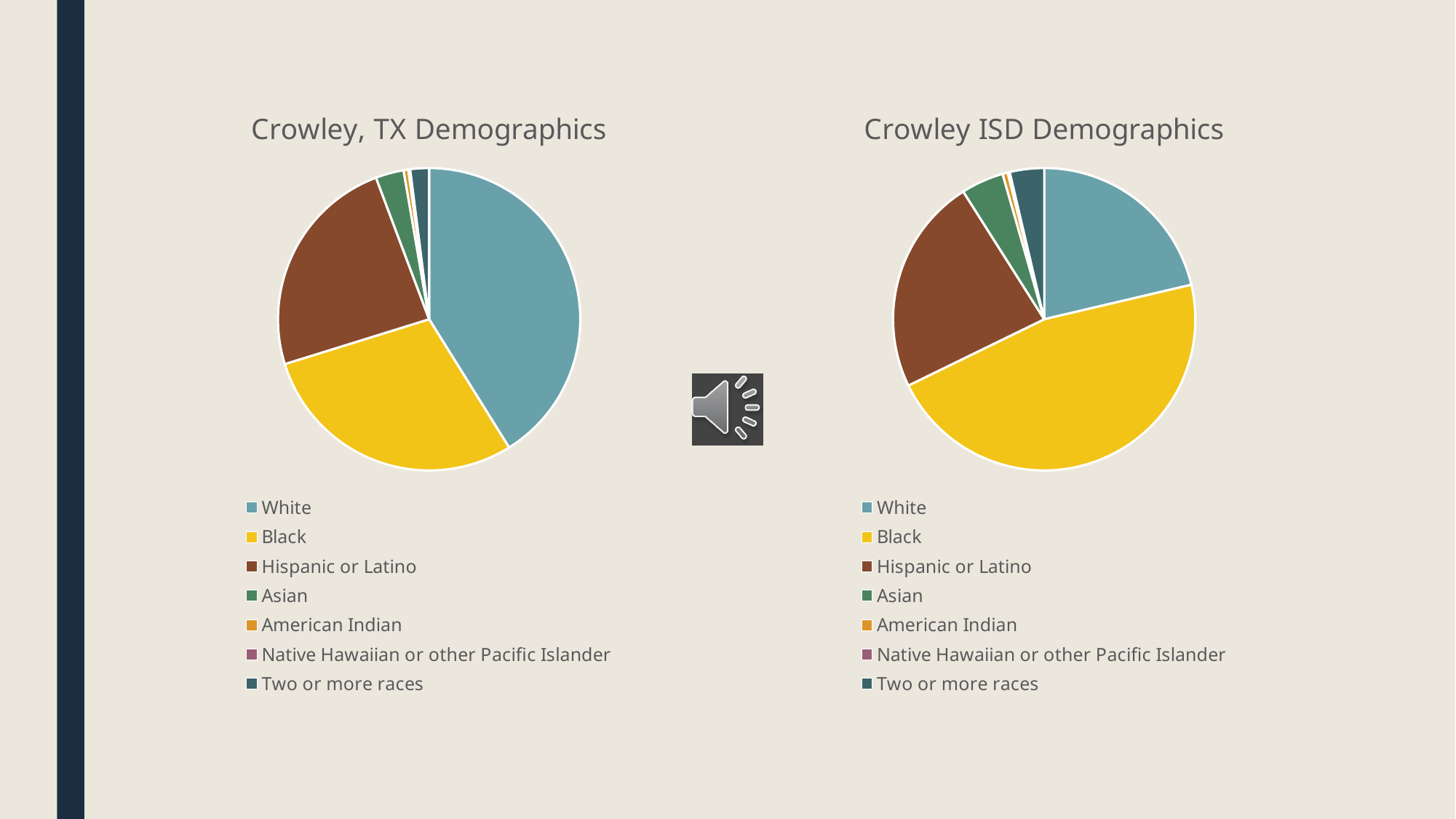
In the "Crowley ISD Demographics" chart, which slice is larger, Hispanic or Latino or Asian? Hispanic or Latino In the "Crowley, TX Demographics" chart, which slice is larger, White or Black? White In the "Crowley, TX Demographics" chart, which category is shown in yellow? Black In the "Crowley, TX Demographics" chart, which category has the largest slice? White In the "Crowley ISD Demographics" chart, which category has the largest slice? Black How many categories does the legend of the "Crowley, TX Demographics" chart list? 7 What is the title of the pie chart on the right side of the slide? Crowley ISD Demographics In the "Crowley, TX Demographics" chart, which slice is larger, Black or Hispanic or Latino? Black What kind of chart is the "Crowley, TX Demographics" chart? pie chart What kind of chart is the "Crowley ISD Demographics" chart? pie chart How many entries does the legend of the "Crowley ISD Demographics" chart list? 7